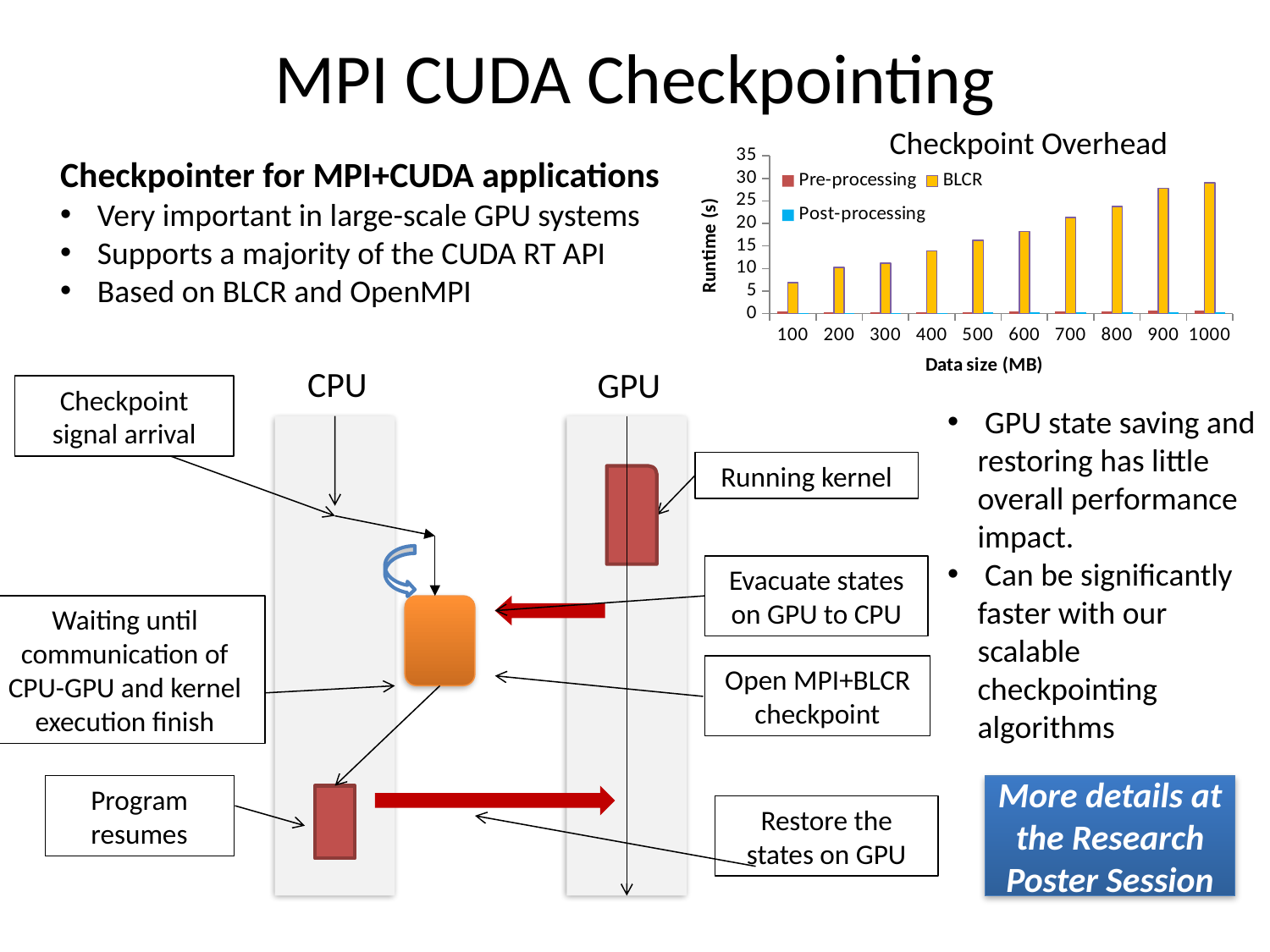
In the Checkpoint Overhead chart, at which data size is the BLCR runtime lowest? 100 How many data size categories are shown on the x axis of the Checkpoint Overhead chart? 10 In the Checkpoint Overhead chart, is the BLCR runtime at 1000 MB greater or less than 25? greater What kind of chart is the Checkpoint Overhead chart? bar chart In the Checkpoint Overhead chart, does the BLCR runtime rise or fall as data size increases? rise In the Checkpoint Overhead chart, which is larger: the BLCR runtime at 900 MB or at 200 MB? 900 MB What is the label of the x axis in the Checkpoint Overhead chart? Data size (MB) In the Checkpoint Overhead chart, at which data size is the BLCR runtime highest? 1000 How many series does the legend of the Checkpoint Overhead chart list? 3 What is the label of the y axis in the Checkpoint Overhead chart? Runtime (s) In the Checkpoint Overhead chart, is the BLCR runtime at 500 MB greater or less than 10? greater In the Checkpoint Overhead chart, is the BLCR runtime at 100 MB greater or less than 10? less